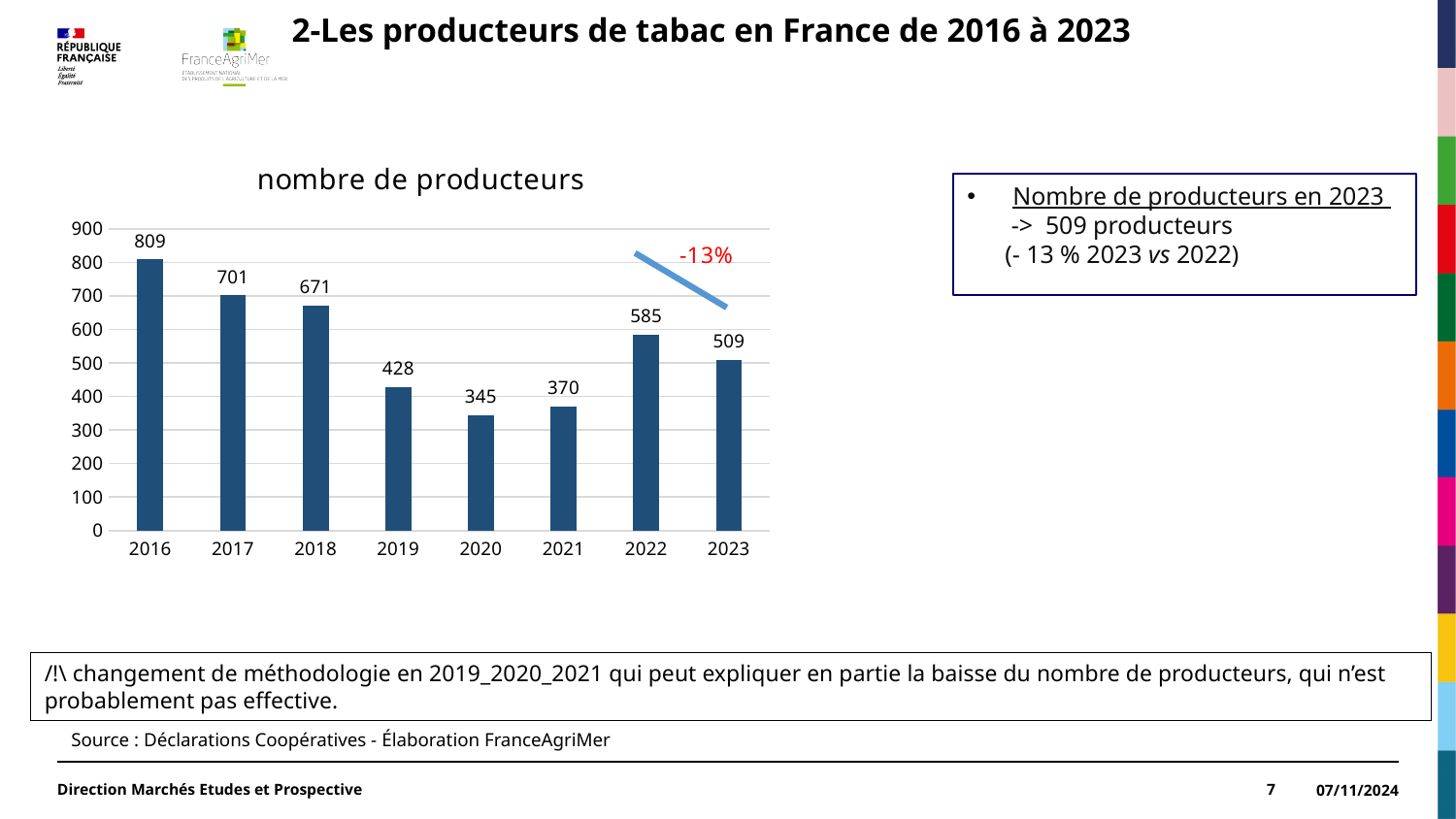
What is the number of producers in 2020? 345 Which year has more producers, 2019 or 2021? 2019 Does the number of producers rise or fall from 2016 to 2020? Fall How many years are shown on the x axis of the chart? 8 What type of chart is used to show the number of producers? Bar chart What is the difference in the number of producers between 2022 and 2023? 76 What is the difference in the number of producers between 2016 and 2017? 108 What is the title of the chart? nombre de producteurs What is the number of producers in 2016? 809 What is the number of producers in 2023? 509 Which year has the highest number of producers? 2016 Which year has the lowest number of producers? 2020